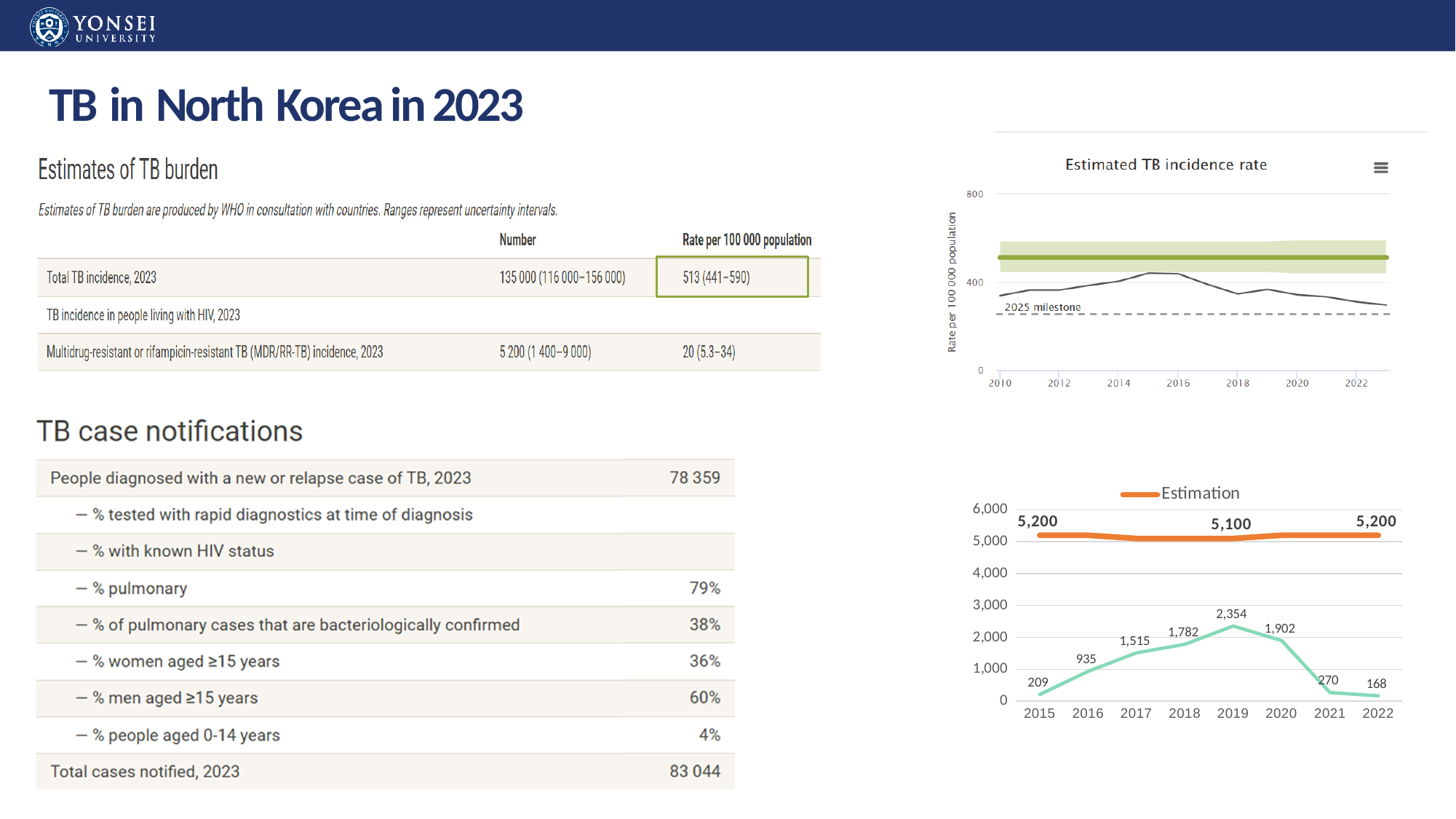
In the bottom-right chart, which is larger on the green line, 2017 or 2018? 2018 In the bottom-right chart, does the green line rise or fall from 2015 to 2019? rise In the bottom-right chart, which year has the highest value on the green line? 2019 In the bottom-right chart, what is the value for 2019 on the green line? 2,354 What kind of chart is the 'Estimated TB incidence rate' chart at the top right? line chart In the bottom-right chart, how many years are shown on the x axis? 8 In the bottom-right chart, what series name does the legend show? Estimation In the 'Estimated TB incidence rate' chart, is the value for 2022 greater or less than 400? less In the 'Estimated TB incidence rate' chart, is the value for 2015 greater or less than 400? greater In the bottom-right chart, which year has the lowest value on the green line? 2022 In the bottom-right chart, what is the value for 2021 on the green line? 270 In the bottom-right chart, what is the difference between the green-line values for 2019 and 2020? 452